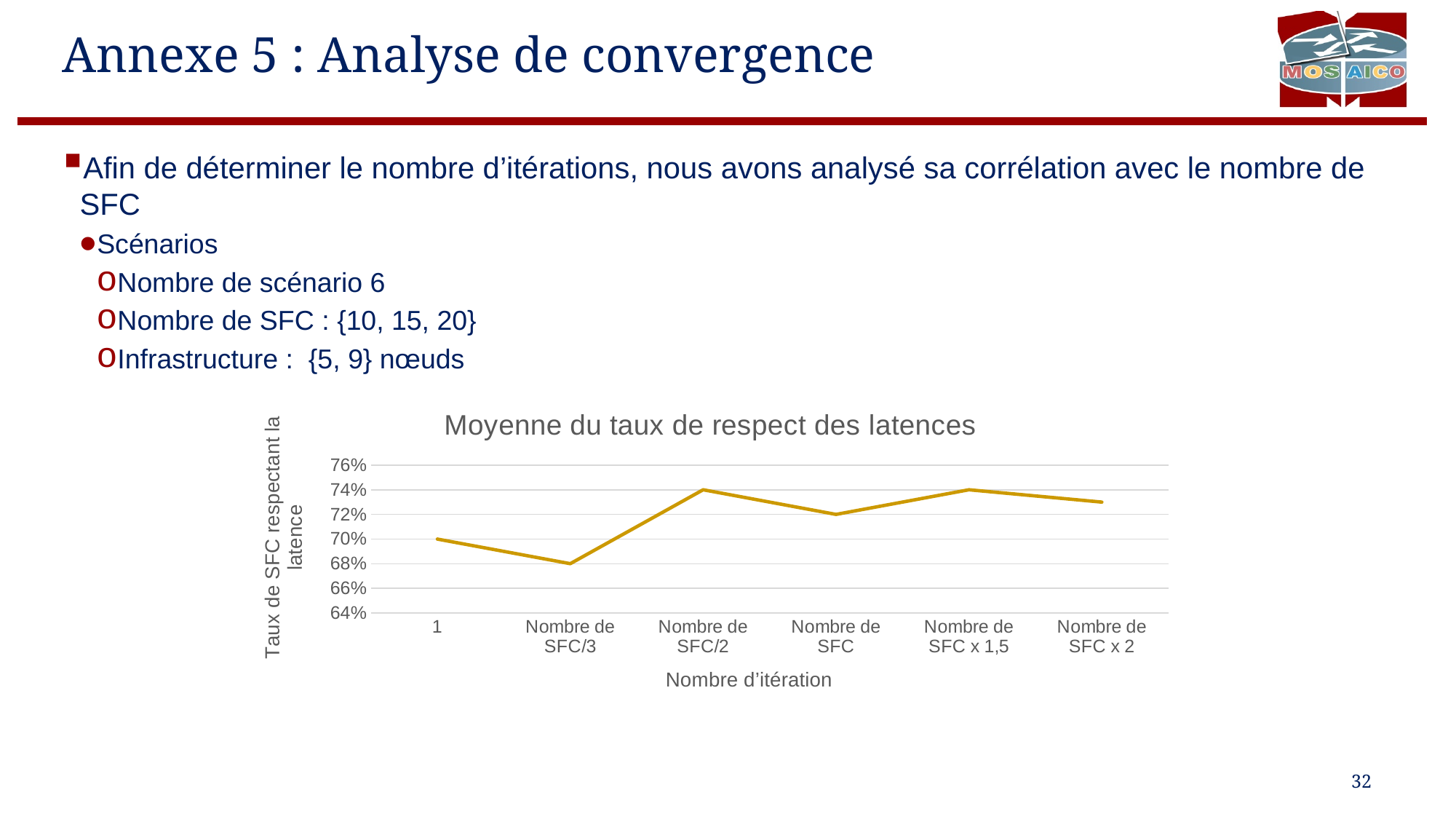
What is the difference between the values for "Nombre de SFC/2" and "Nombre de SFC/3"? 6 percentage points How many data points are plotted on the line? 6 What is the value for "Nombre de SFC/2"? 74% What is the value for "Nombre de SFC/3"? 68% What type of chart is shown on the slide? Line chart Which category has the lowest value? Nombre de SFC/3 Is the value for "Nombre de SFC x 2" greater or less than 70%? greater What is the title of the chart? Moyenne du taux de respect des latences Which is larger, the value for "Nombre de SFC/2" or the value for "Nombre de SFC"? Nombre de SFC/2 What is the label of the x axis of the chart? Nombre d’itération What is the value for "Nombre de SFC"? 72% What is the value for the category "1"? 70%